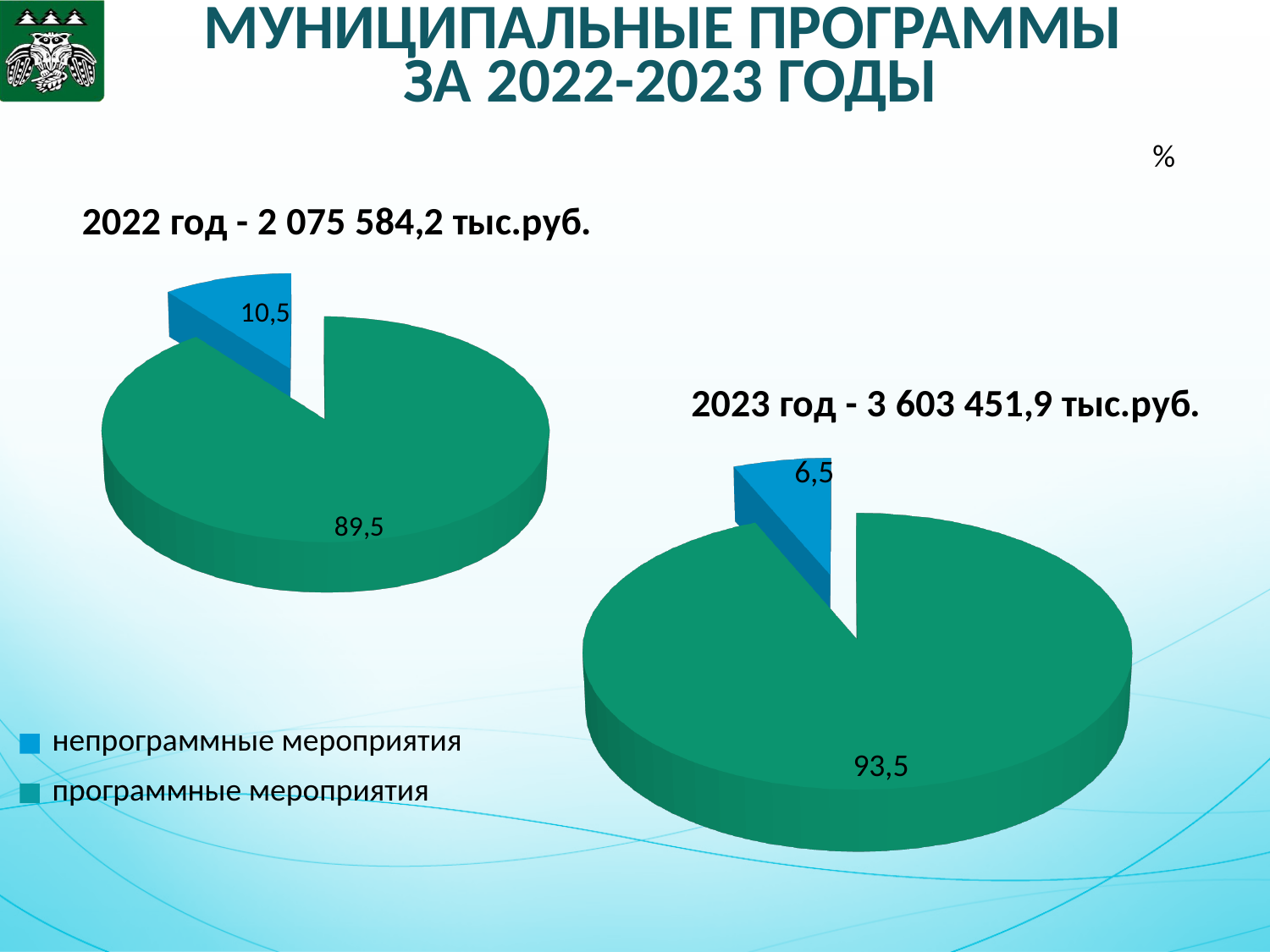
How many slices does the 2023 pie chart have? 2 In the 2022 pie chart, what is the value for непрограммные мероприятия? 10,5 In the 2023 pie chart, what is the value for непрограммные мероприятия? 6,5 In the 2023 pie chart, which category has the largest slice? программные мероприятия In the 2022 pie chart, which category has the smallest slice? непрограммные мероприятия What is the difference between the программные мероприятия value in the 2022 pie chart and the непрограммные мероприятия value in the same chart? 79 How many entries does the legend on the slide list? 2 In the 2022 pie chart, what is the value for программные мероприятия? 89,5 What colour represents непрограммные мероприятия in the pie charts? Blue In the 2023 pie chart, what is the value for программные мероприятия? 93,5 Which is larger: the непрограммные мероприятия value in the 2022 pie chart or in the 2023 pie chart? 2022 What kind of chart is used for the 2022 data on the slide? Pie chart